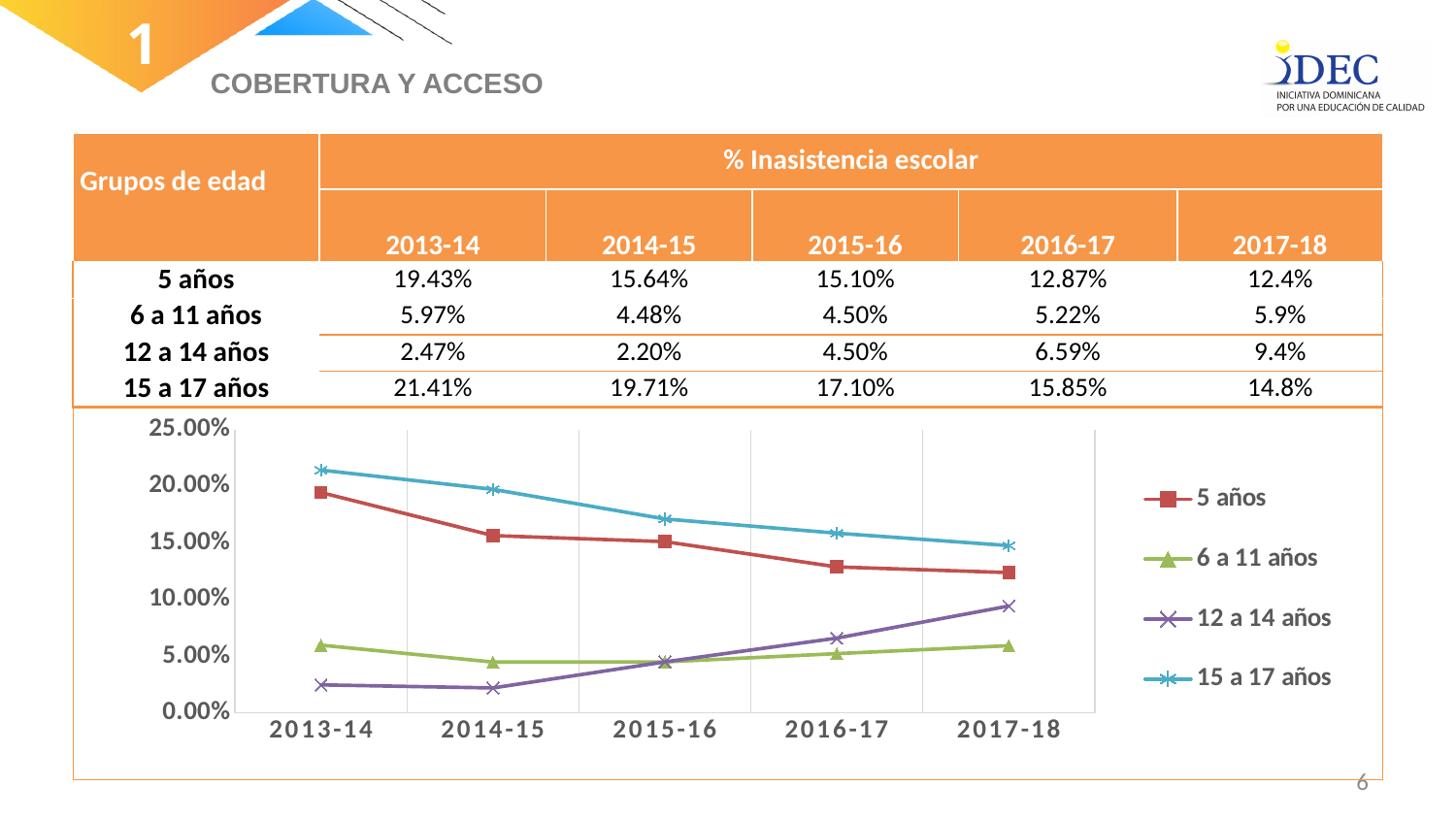
In 2016-17, which is larger: the value for 12 a 14 años or for 6 a 11 años? 12 a 14 años Which age group has the highest % Inasistencia escolar in 2013-14? 15 a 17 años How many school-year points are plotted along the x axis? 5 Which age group has the lowest % Inasistencia escolar in 2014-15? 12 a 14 años What type of chart is shown on the slide? line chart Does the % Inasistencia escolar for 12 a 14 años rise or fall from 2014-15 to 2017-18? rise How many series does the chart legend list? 4 What is the % Inasistencia escolar for 5 años in 2013-14? 19.43% What is the % Inasistencia escolar for 15 a 17 años in 2015-16? 17.10% What is the % Inasistencia escolar for 12 a 14 años in 2017-18? 9.4% What is the difference between the 15 a 17 años and 5 años values in 2017-18? 2.4% Is the value for 5 años in 2017-18 greater or less than 15.00%? less